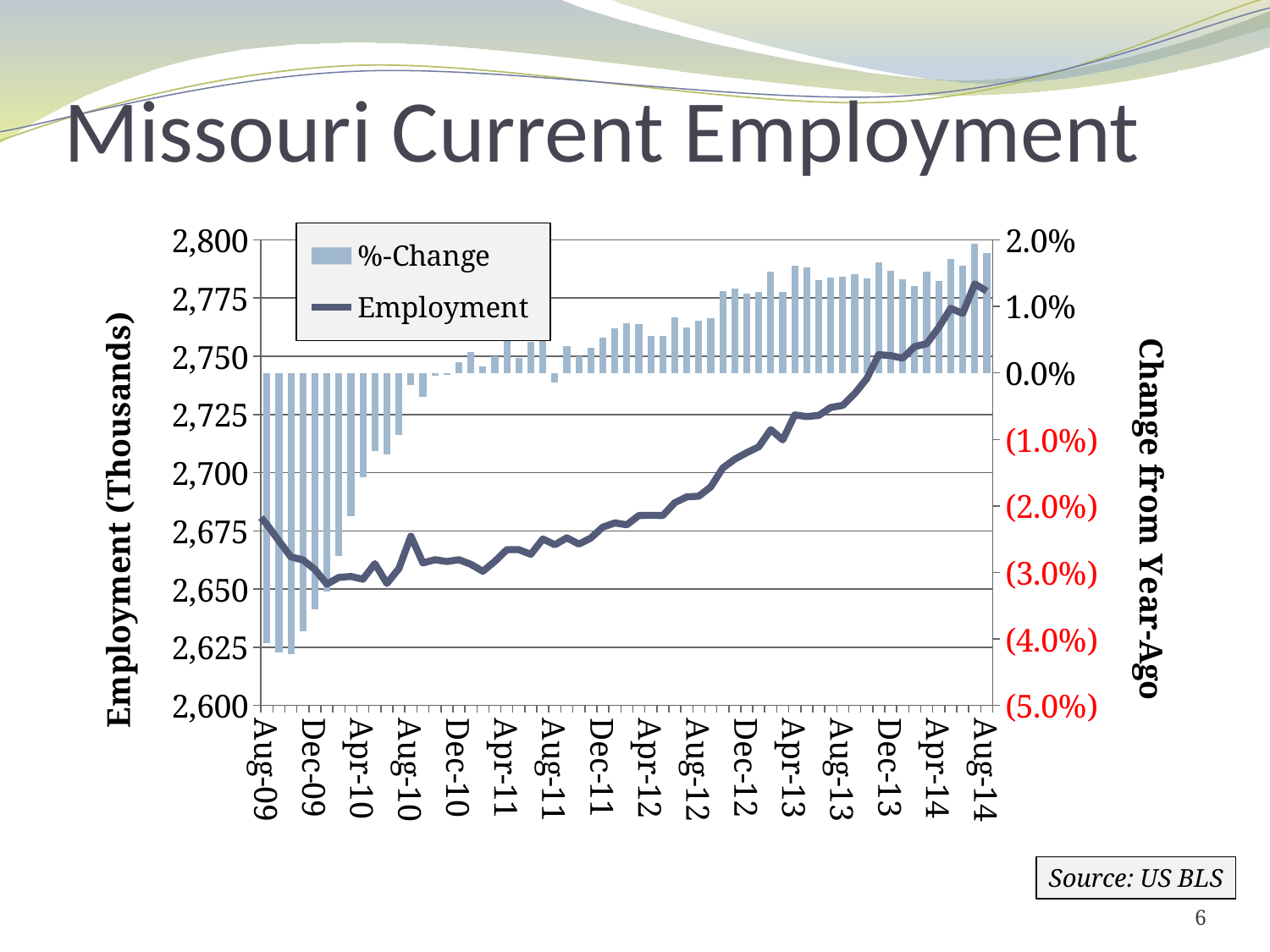
Is the Employment value for Dec-09 greater or less than 2,675? less Does the Employment line generally rise or fall from Aug-09 to Aug-14? Rise What kind of chart is shown on the slide? A combination bar and line chart Is the %-Change value for Aug-14 greater or less than 1.0%? greater Is the Employment value for Aug-14 greater or less than 2,750? greater Which is larger, the Employment value for Aug-09 or for Aug-14? Aug-14 How many series does the legend list? 2 Which is larger, the %-Change value for Aug-09 or for Aug-12? Aug-12 What is the title of the left vertical axis? Employment (Thousands) What are the two series named in the legend? %-Change and Employment Which month has the highest %-Change bar? Jul-14